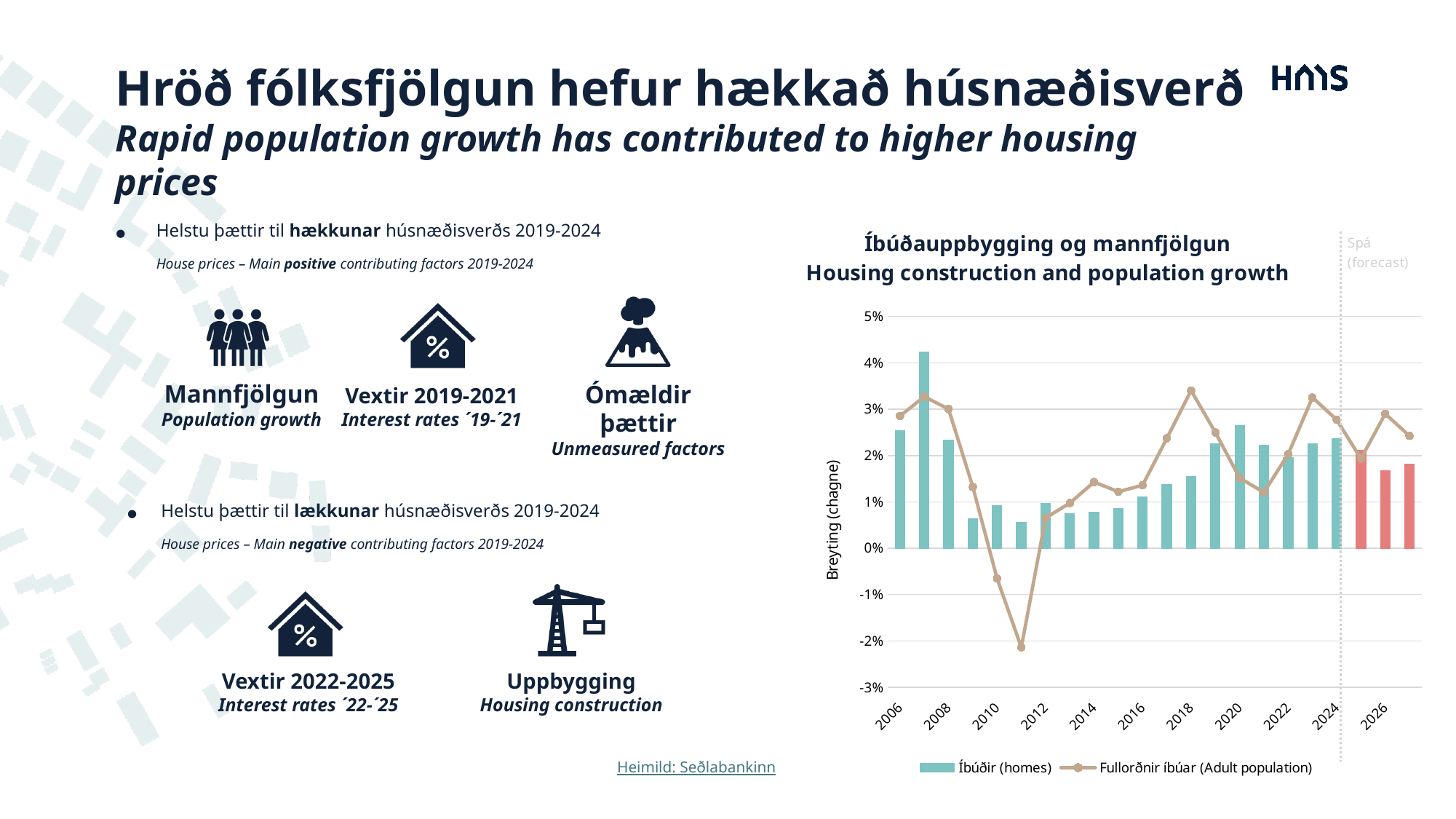
How many series does the legend of the "Housing construction and population growth" chart list? 2 In the "Housing construction and population growth" chart, which year has the tallest bar for Íbúðir (homes)? 2007 In the "Housing construction and population growth" chart, is the Fullorðnir íbúar (Adult population) value for 2011 greater or less than -2%? less What are the two legend entries of the "Housing construction and population growth" chart? Íbúðir (homes) and Fullorðnir íbúar (Adult population) In the "Housing construction and population growth" chart, is the Íbúðir (homes) bar for 2007 greater or less than 4%? greater In the "Housing construction and population growth" chart, in which year does the Fullorðnir íbúar (Adult population) line reach its lowest point? 2011 What kind of chart is shown under the title "Housing construction and population growth"? A combined bar and line chart In the "Housing construction and population growth" chart, is the Íbúðir (homes) bar for 2011 greater or less than 1%? less What label marks the dotted vertical line on the right side of the "Housing construction and population growth" chart? Spá (forecast) In the "Housing construction and population growth" chart, does the Fullorðnir íbúar (Adult population) line rise or fall between 2008 and 2011? fall In the "Housing construction and population growth" chart, which is taller: the Íbúðir (homes) bar for 2007 or for 2020? 2007